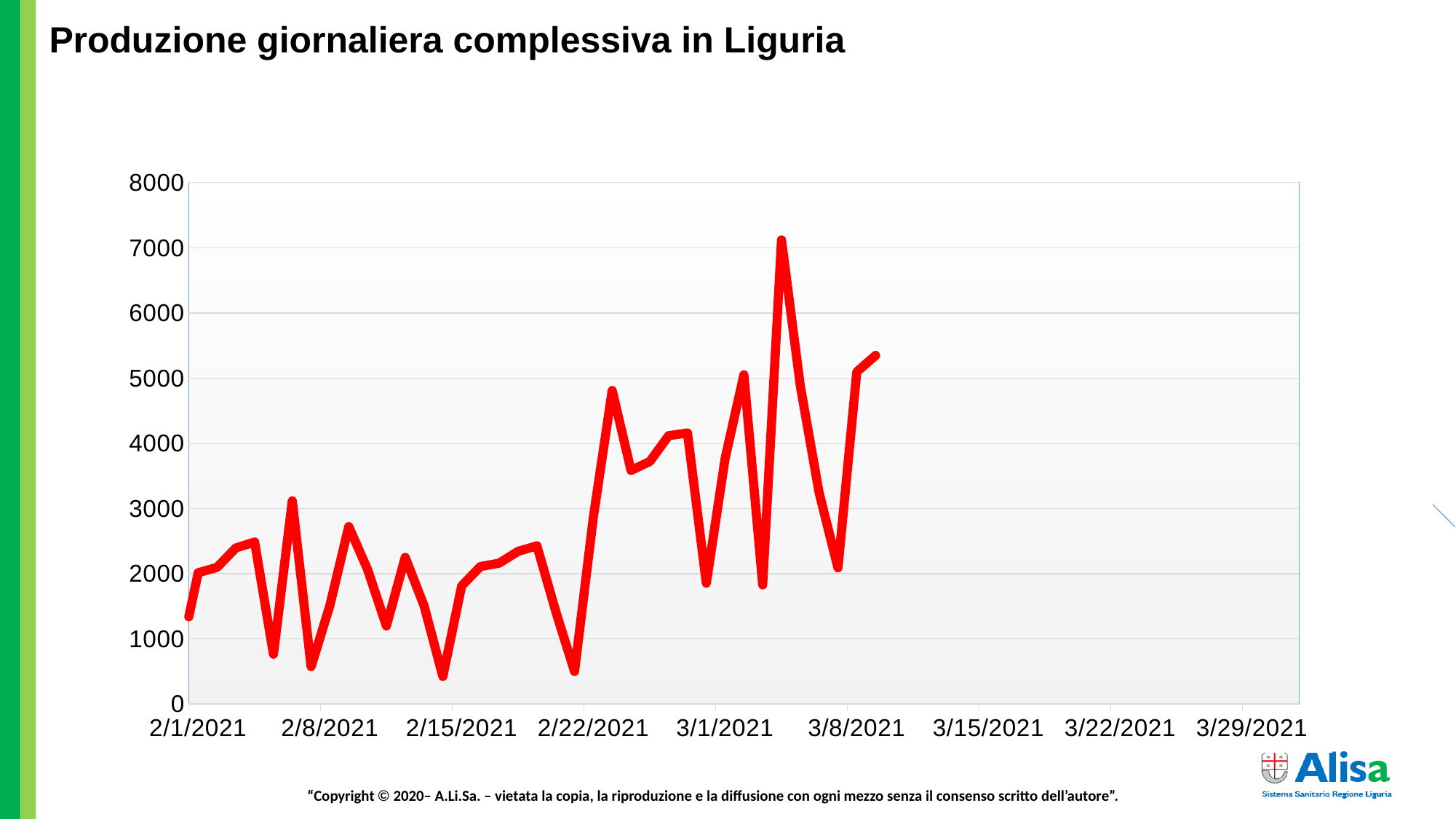
Is the highest value on the line greater or less than 6000? greater What colour is the plotted line? red Is the value for 2/8/2021 greater or less than 1000? greater Is the value for 3/8/2021 greater or less than 3000? greater What kind of chart is shown on the slide? line chart Between which two labelled dates on the x axis does the line reach its highest peak? between 3/1/2021 and 3/8/2021 What is the title of the chart? Produzione giornaliera complessiva in Liguria Overall, do the values rise or fall from 2/1/2021 to the end of the plotted line? rise